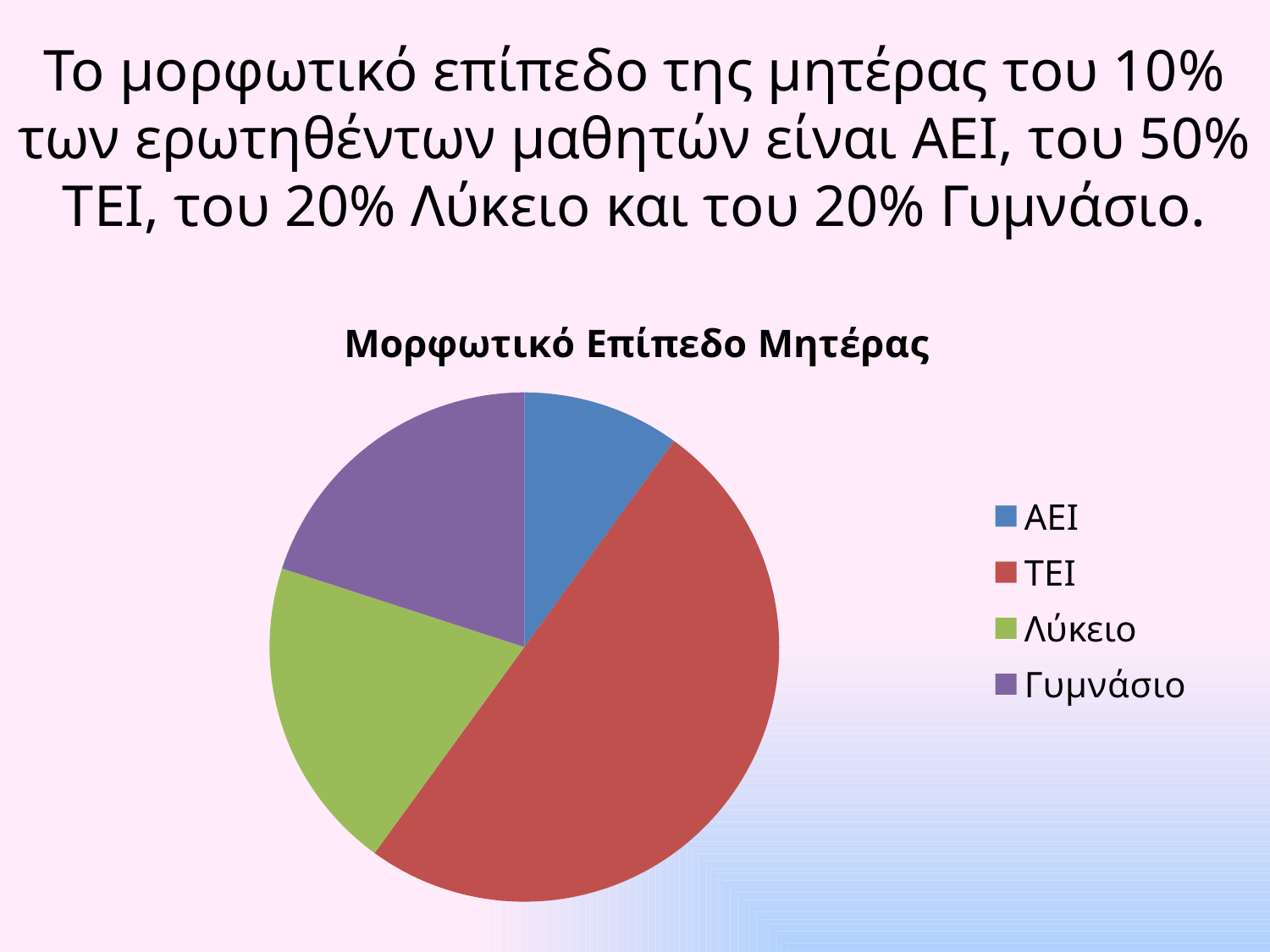
Which slice is larger, ΤΕΙ or Λύκειο? ΤΕΙ Which category has the smallest slice of the pie? ΑΕΙ What colour is the ΤΕΙ slice in the pie chart? Red What is the title of the chart? Μορφωτικό Επίπεδο Μητέρας Which category has the largest slice of the pie? ΤΕΙ According to the slide, what share of the pie does ΤΕΙ represent? 50% According to the slide, what share of the pie does Λύκειο represent? 20% What kind of chart is shown on the slide? Pie chart Which slice is larger, Γυμνάσιο or ΑΕΙ? Γυμνάσιο According to the slide, what share of the pie does ΑΕΙ represent? 10% How many categories does the pie chart have? 4 Is the ΤΕΙ slice greater or less than half of the pie? Half (50%)